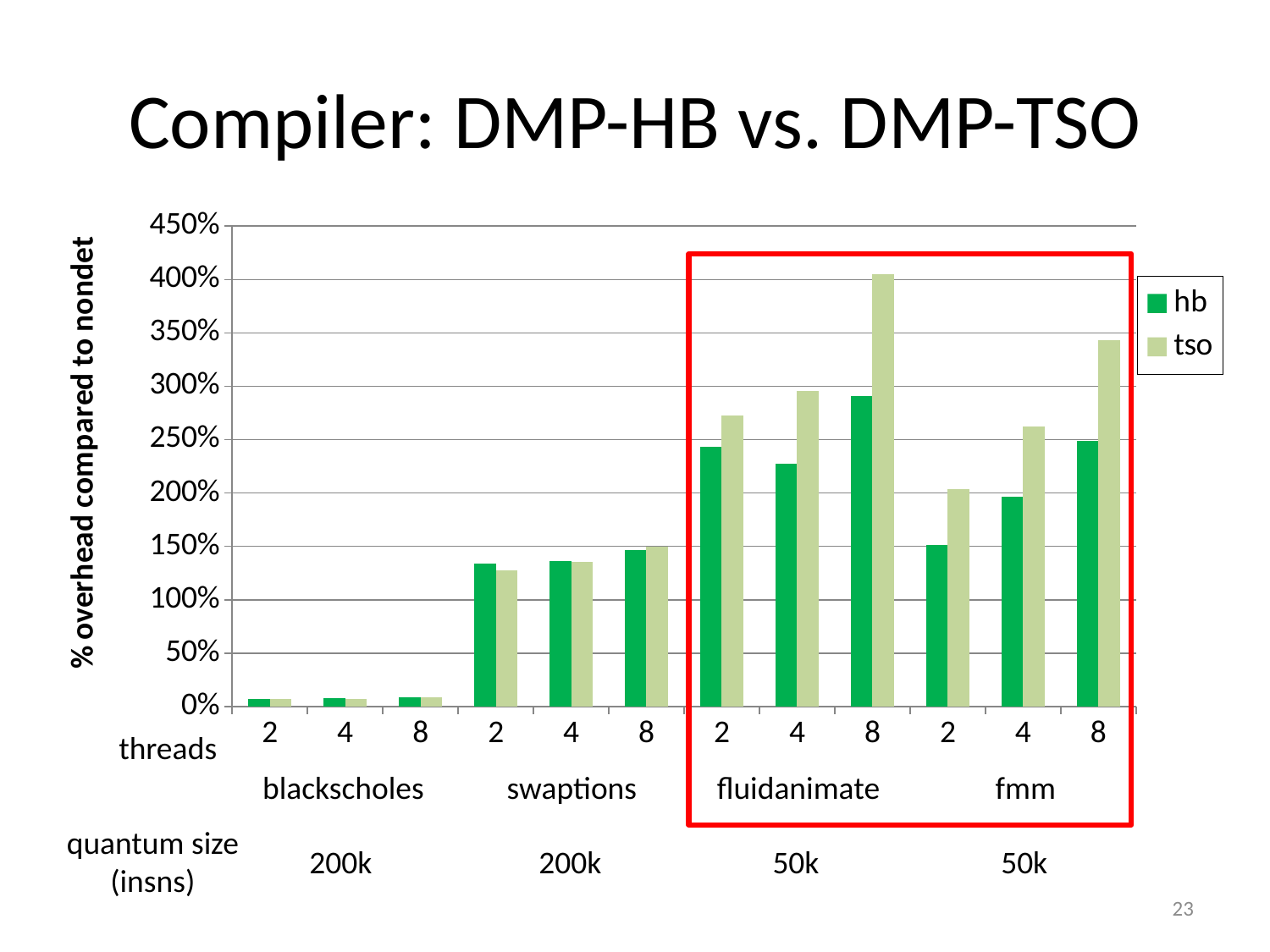
For fmm, do the hb bars rise or fall as the thread count increases from 2 to 8? rise Is the hb value for fluidanimate at 8 threads greater or less than 250%? greater What quantum size (insns) is listed for fluidanimate? 50k For fmm at 8 threads, which is larger, hb or tso? tso Is the tso value for fluidanimate at 8 threads greater or less than 350%? greater Which benchmark and thread count has the highest tso bar? fluidanimate, 8 threads What are the two series named in the legend? hb and tso Is the hb value for fmm at 2 threads greater or less than 200%? less What kind of chart is shown on the slide? bar chart Which benchmark has the lowest overhead bars overall? blackscholes How many series does the legend list? 2 How many benchmarks are shown along the x axis? 4